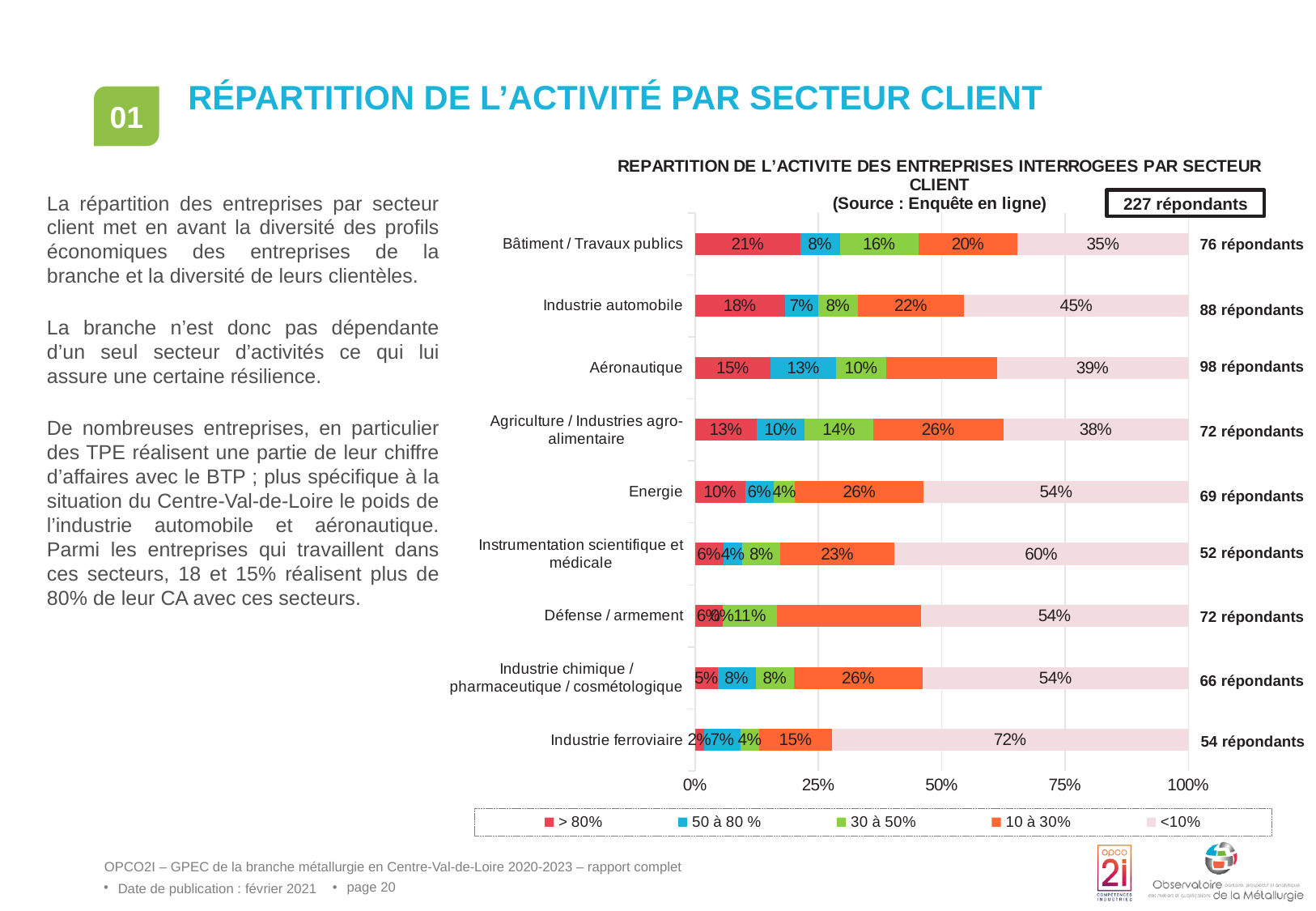
Which sector has the highest "<10%" share? Industrie ferroviaire Which sector has the highest "> 80%" share? Bâtiment / Travaux publics Which has a larger "50 à 80 %" share: Aéronautique or Industrie automobile? Aéronautique What is the "<10%" value for Industrie automobile? 45% How many series does the legend list? 5 How many respondents are indicated for Aéronautique? 98 répondants What type of chart is shown on the slide? Stacked bar chart What percentage of Bâtiment / Travaux publics companies fall in the "> 80%" category? 21% What is the difference between the "<10%" values for Industrie automobile and Bâtiment / Travaux publics? 10 percentage points What is the "10 à 30%" value for Energie? 26% How many client sectors are shown in the chart? 9 Which sector has the lowest "> 80%" share? Industrie ferroviaire